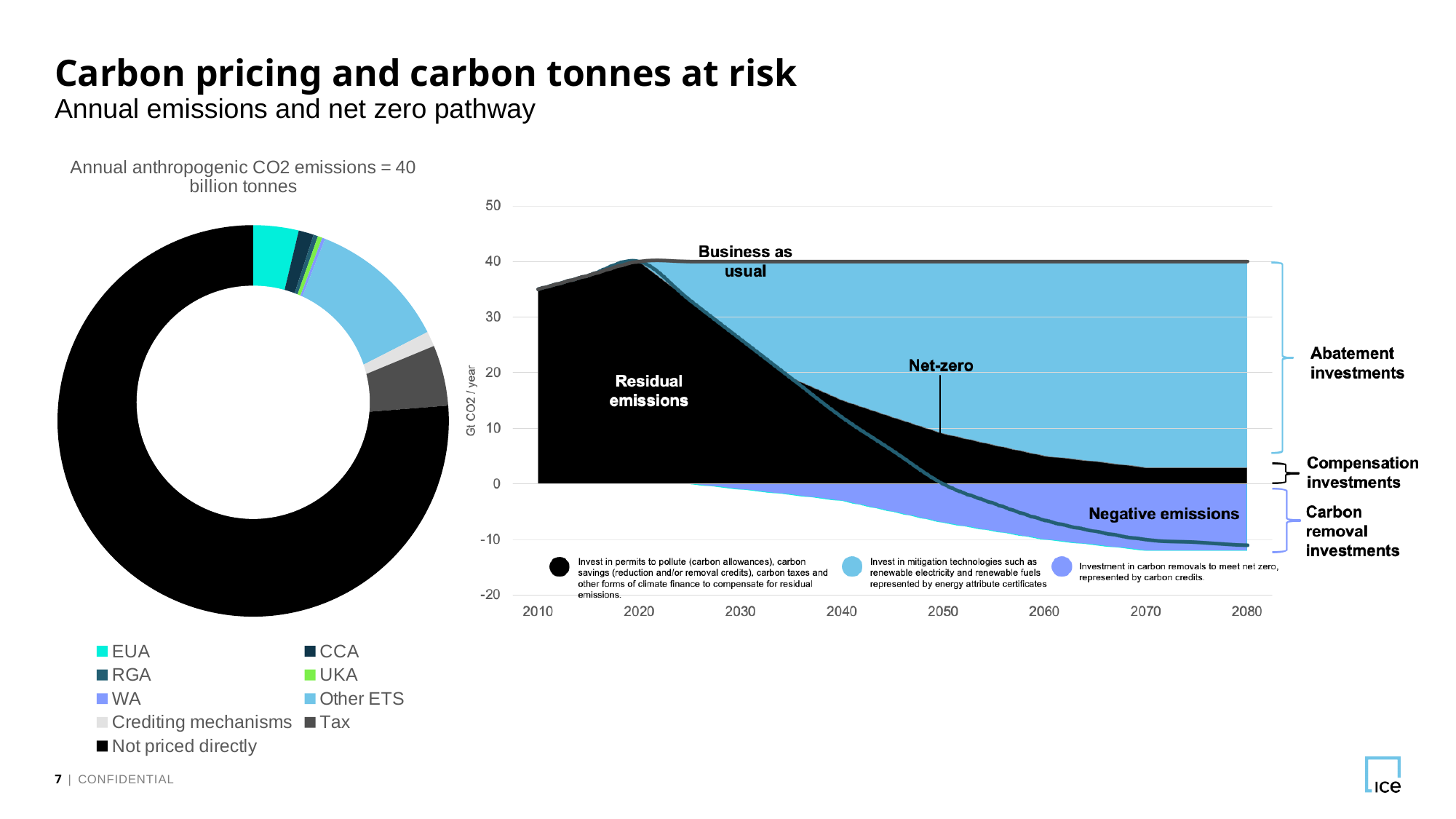
What kind of chart is the chart on the left of the slide? Pie (donut) chart In the right area chart, do residual emissions rise or fall between 2020 and 2080? Fall In the right area chart, is the Business as usual level in 2080 greater or less than 30? greater What kind of chart is the chart on the right of the slide? Area chart In the right area chart, is the residual emissions value in 2050 greater or less than 20? less In the left donut chart, how many categories does the legend list? 9 In the left donut chart, which category has the largest share? Not priced directly In the right area chart, how many year labels are shown on the x axis? 8 In the left donut chart, which is larger, the Other ETS slice or the EUA slice? Other ETS What is the y-axis label of the right area chart? Gt CO2 / year What is the title of the left donut chart? Annual anthropogenic CO2 emissions = 40 billion tonnes In the left donut chart, which is larger, the Tax slice or the UKA slice? Tax